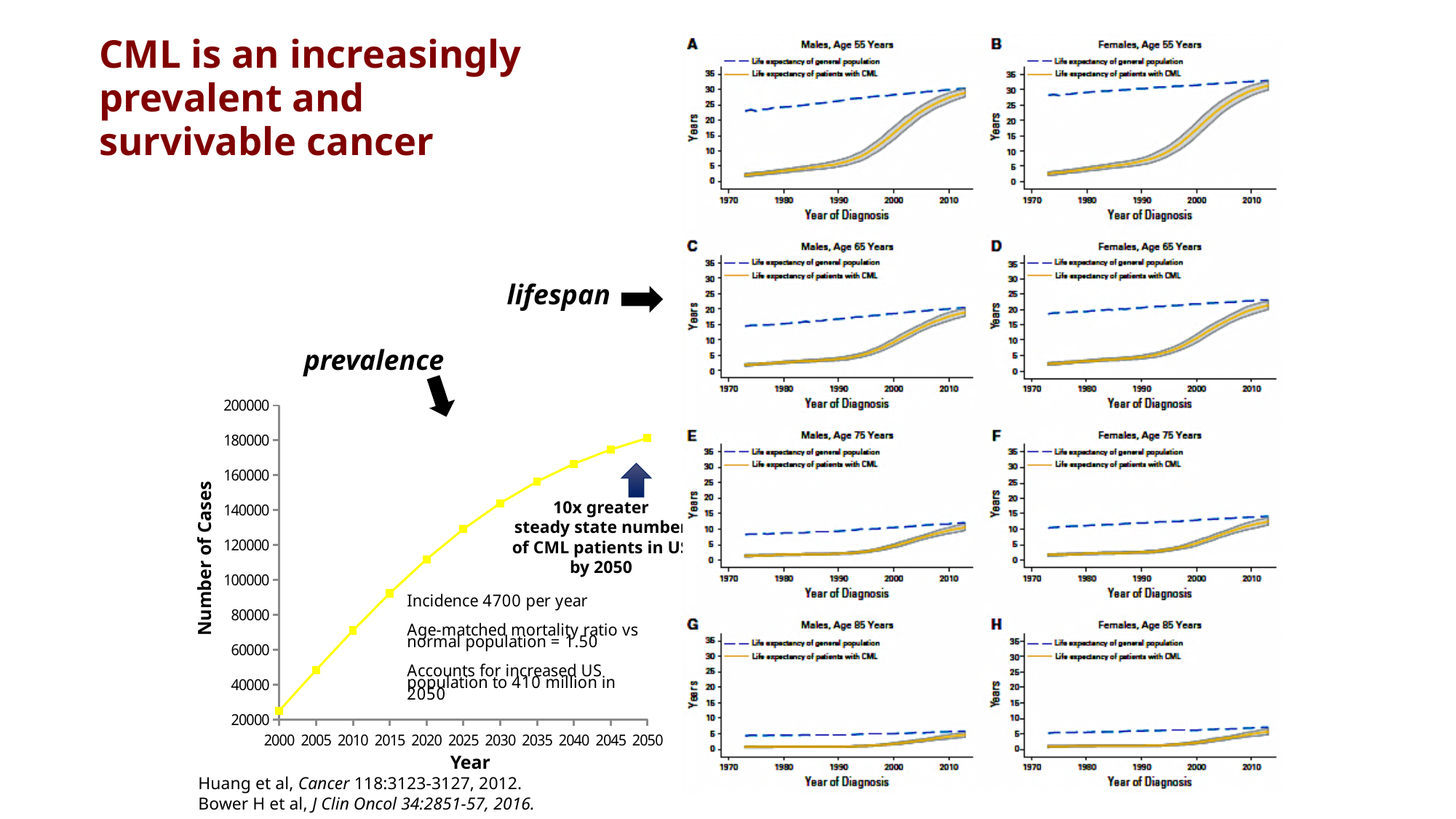
On the prevalence chart, is the number of cases in 2000 greater or less than 40000? less On the prevalence chart, which year has the lowest number of cases? 2000 In lifespan panel A (Males, Age 55 Years), does the life expectancy of patients with CML rise or fall with year of diagnosis? rise On the prevalence chart, do the number of cases rise or fall from 2000 to 2050? rise On the prevalence chart, which year has the highest number of cases? 2050 How many lifespan panels (A through H) are shown on the right side of the slide? 8 In lifespan panel A (Males, Age 55 Years), how many series does the legend list? 2 On the prevalence chart, is the number of cases in 2020 greater or less than 100000? greater On the prevalence chart (Number of Cases vs Year), how many data points are plotted? 11 On the prevalence chart, is the number of cases in 2050 greater or less than 160000? greater What kind of chart is the prevalence chart on the left of the slide? line chart